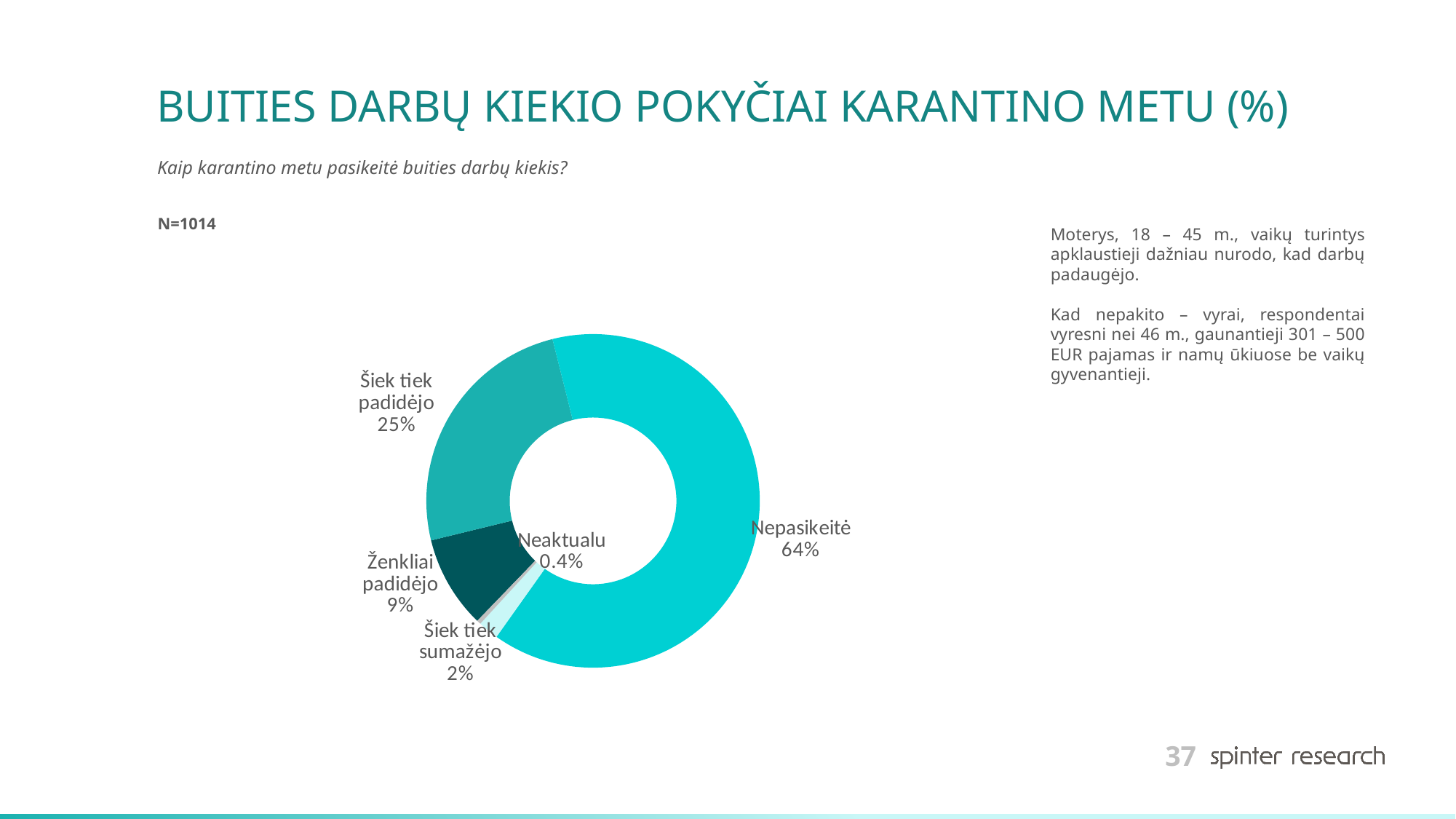
Which category has the largest share of the chart? Nepasikeitė Which category has the smallest share of the chart? Neaktualu What kind of chart is shown on the slide? Doughnut (pie) chart What percentage of respondents answered "Neaktualu"? 0.4% What percentage of respondents answered "Ženkliai padidėjo"? 9% What percentage of respondents answered "Nepasikeitė"? 64% Which is larger, the share for "Ženkliai padidėjo" or the share for "Šiek tiek sumažėjo"? Ženkliai padidėjo What is the difference in percentage points between "Nepasikeitė" and "Šiek tiek padidėjo"? 39 What percentage of respondents answered "Šiek tiek sumažėjo"? 2% What percentage of respondents answered "Šiek tiek padidėjo"? 25% How many categories are shown in the chart? 5 What is the sample size (N) stated on the slide? N=1014